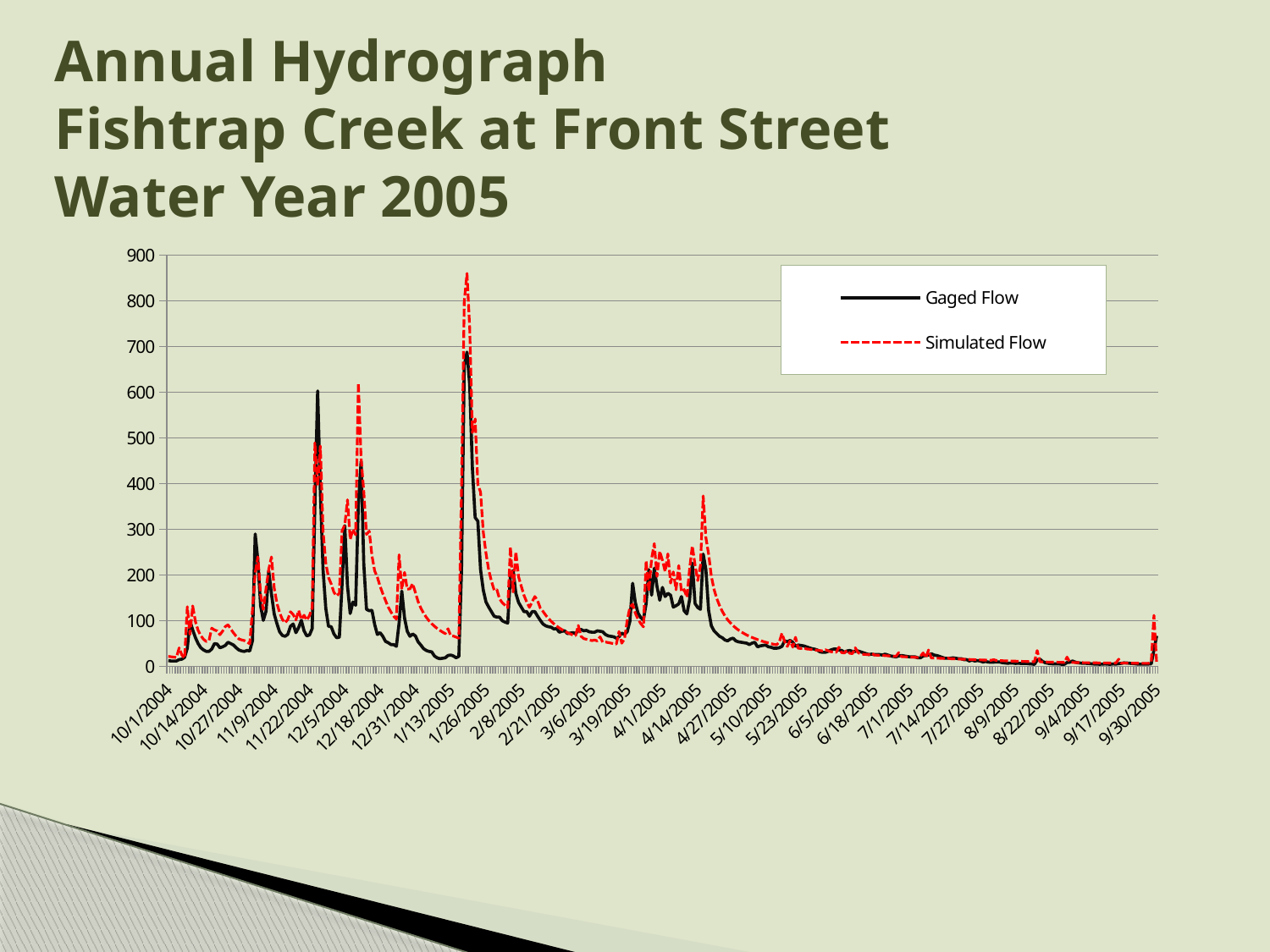
Is the highest peak of Simulated Flow (around 1/26/2005) greater or less than 800? greater Is the Simulated Flow peak around 4/27/2005 greater or less than 300? greater At the largest peak near 1/26/2005, which series is higher, Gaged Flow or Simulated Flow? Simulated Flow What kind of chart is shown on the slide? line chart Which series reaches the highest value anywhere on the chart? Simulated Flow Is the highest peak of Gaged Flow (around 1/26/2005) greater or less than 600? greater How many series does the legend list? 2 What are the two series named in the legend? Gaged Flow and Simulated Flow What is the highest value shown on the vertical axis? 900 Do the flow values generally rise or fall from late April 2005 through September 2005? fall Which series is drawn as a red dashed line? Simulated Flow